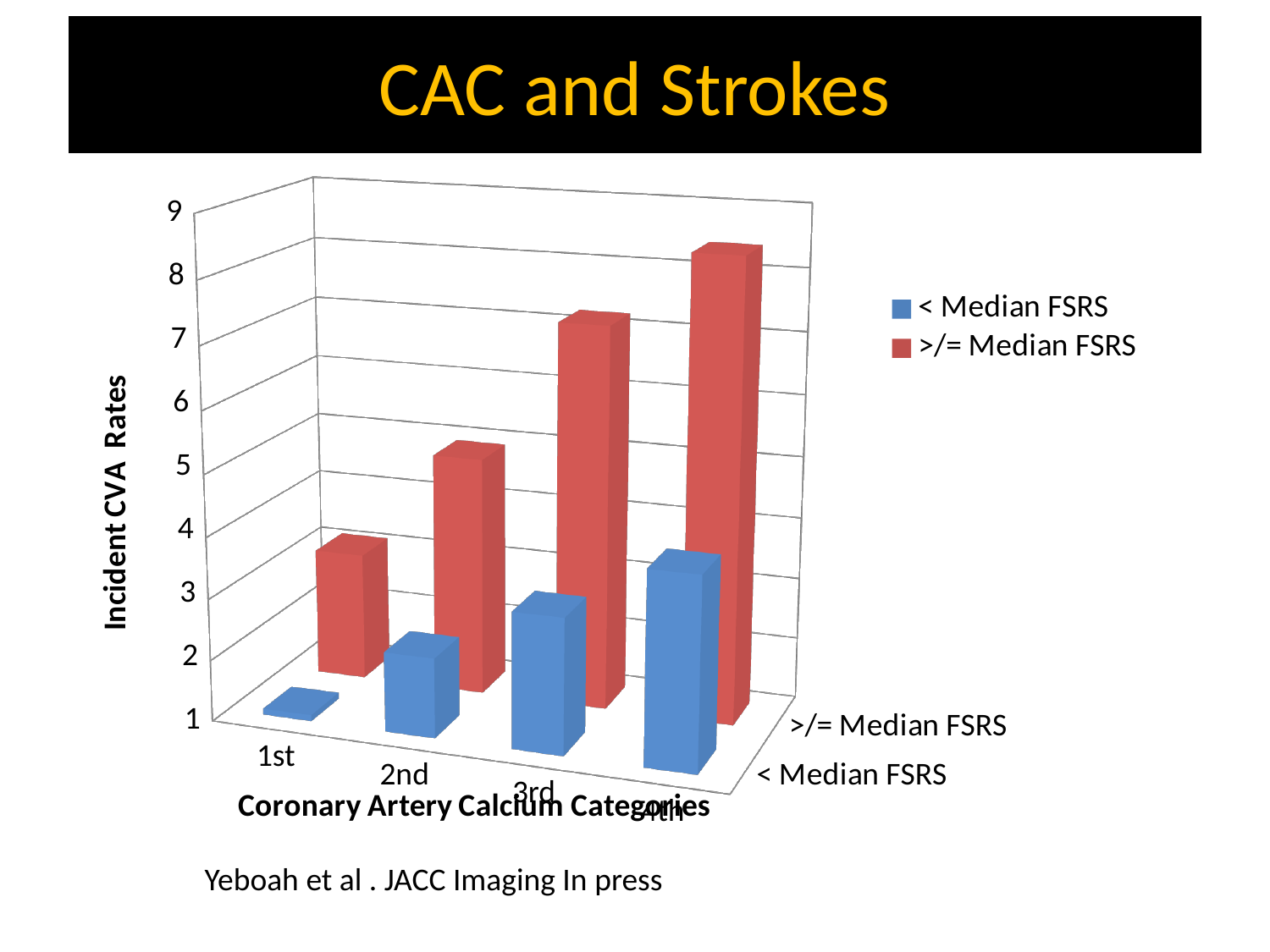
How many Coronary Artery Calcium categories are shown on the x axis? 4 Which category has the lowest value for the >/= Median FSRS series? 1st Is the value for the 1st category in the < Median FSRS series greater or less than 2? less Is the value for the 4th category in the >/= Median FSRS series greater or less than 6? greater What kind of chart is shown on the slide? bar chart Which category has the lowest value for the < Median FSRS series? 1st Which colour represents the < Median FSRS series? blue For the 4th category, which series has the larger value, < Median FSRS or >/= Median FSRS? >/= Median FSRS Which category has the highest value for the >/= Median FSRS series? 4th What is the title of the vertical axis? Incident CVA Rates How many series does the legend list? 2 Do the values for the >/= Median FSRS series rise or fall from the 1st to the 4th category? rise